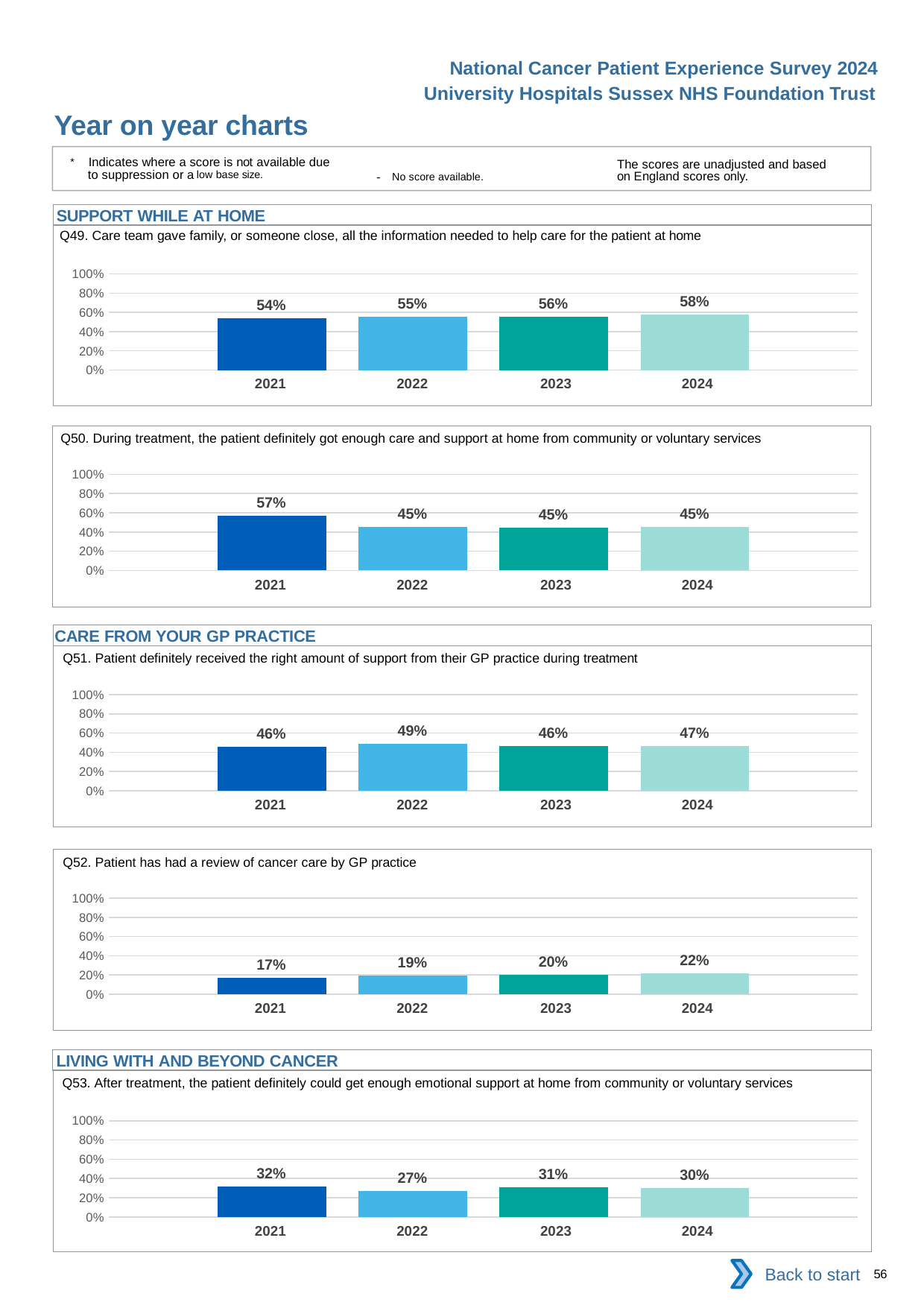
In the Q53 chart, is the value for 2022 larger or smaller than the value for 2023? smaller In the Q49 chart, what is the value for 2024? 58% In the Q50 chart, what is the difference between the 2021 value and the 2022 value? 12% In the Q52 chart, do the values rise or fall from 2021 to 2024? rise In the Q49 chart, how many years are plotted? 4 In the Q53 chart, is the value for 2021 greater or less than 40%? less In the Q51 chart, which year has the highest value? 2022 In the Q49 chart, what is the difference between the 2024 value and the 2021 value? 4% In the Q53 chart, which year has the lowest value? 2022 What kind of chart is the Q51 chart? bar chart In the Q52 chart, what is the value for 2021? 17% In the Q50 chart, which year has the highest value? 2021